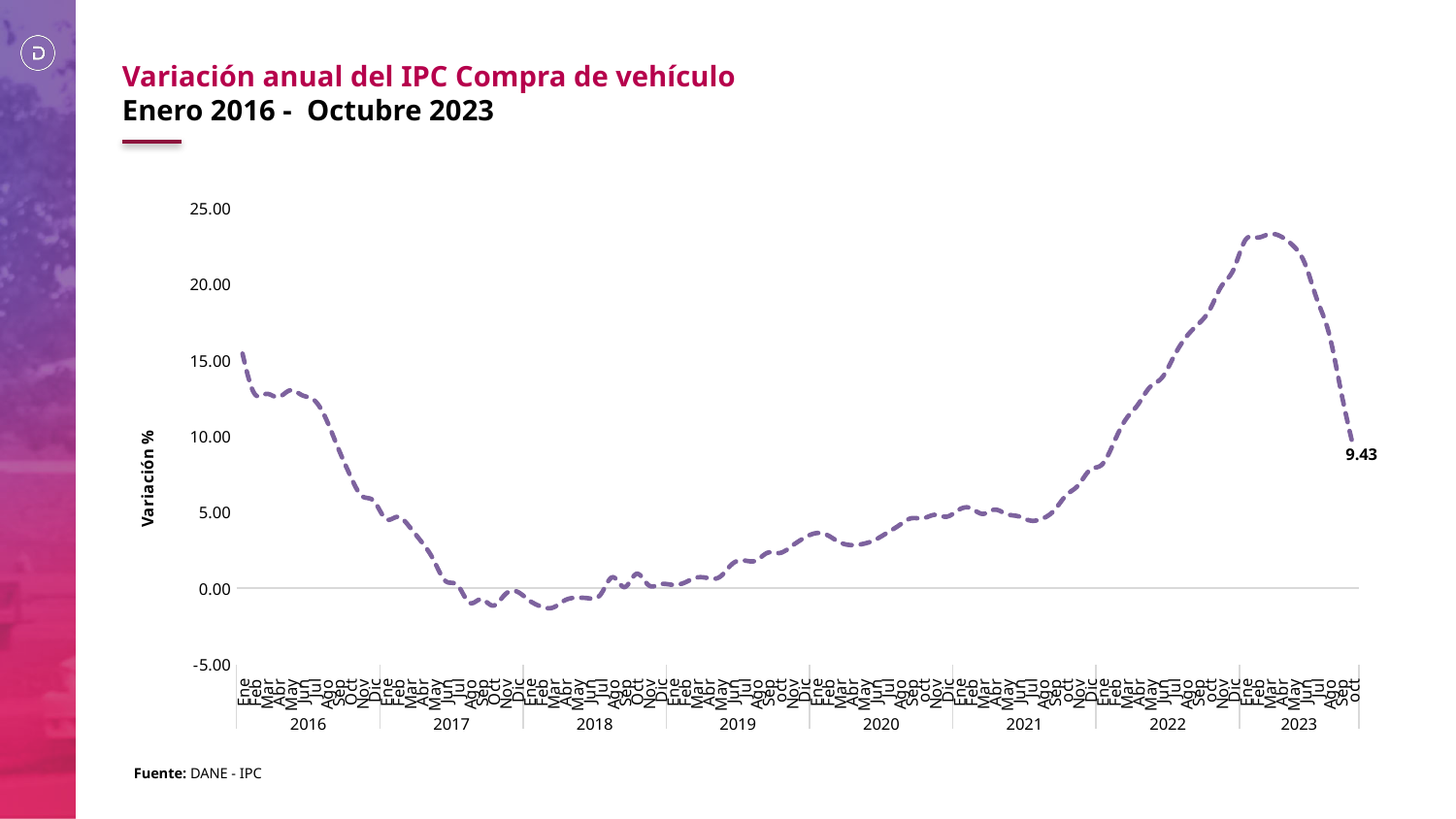
Does the line rise or fall between July 2021 and February 2023? rise Is the value for January 2016 greater or less than 10.00? greater Is the peak value reached in early 2023 greater or less than 20.00? greater Does the line rise or fall between March 2023 and October 2023? fall Is the value for December 2020 greater or less than 10.00? less What kind of chart is shown on the slide? line chart What is the value shown for October 2023 (the last point on the line)? 9.43 What is the label on the vertical axis? Variación % In which year does the line reach its highest value? 2023 Which is larger, the value for January 2016 or the value for October 2023? January 2016 How many years are labelled along the x axis? 8